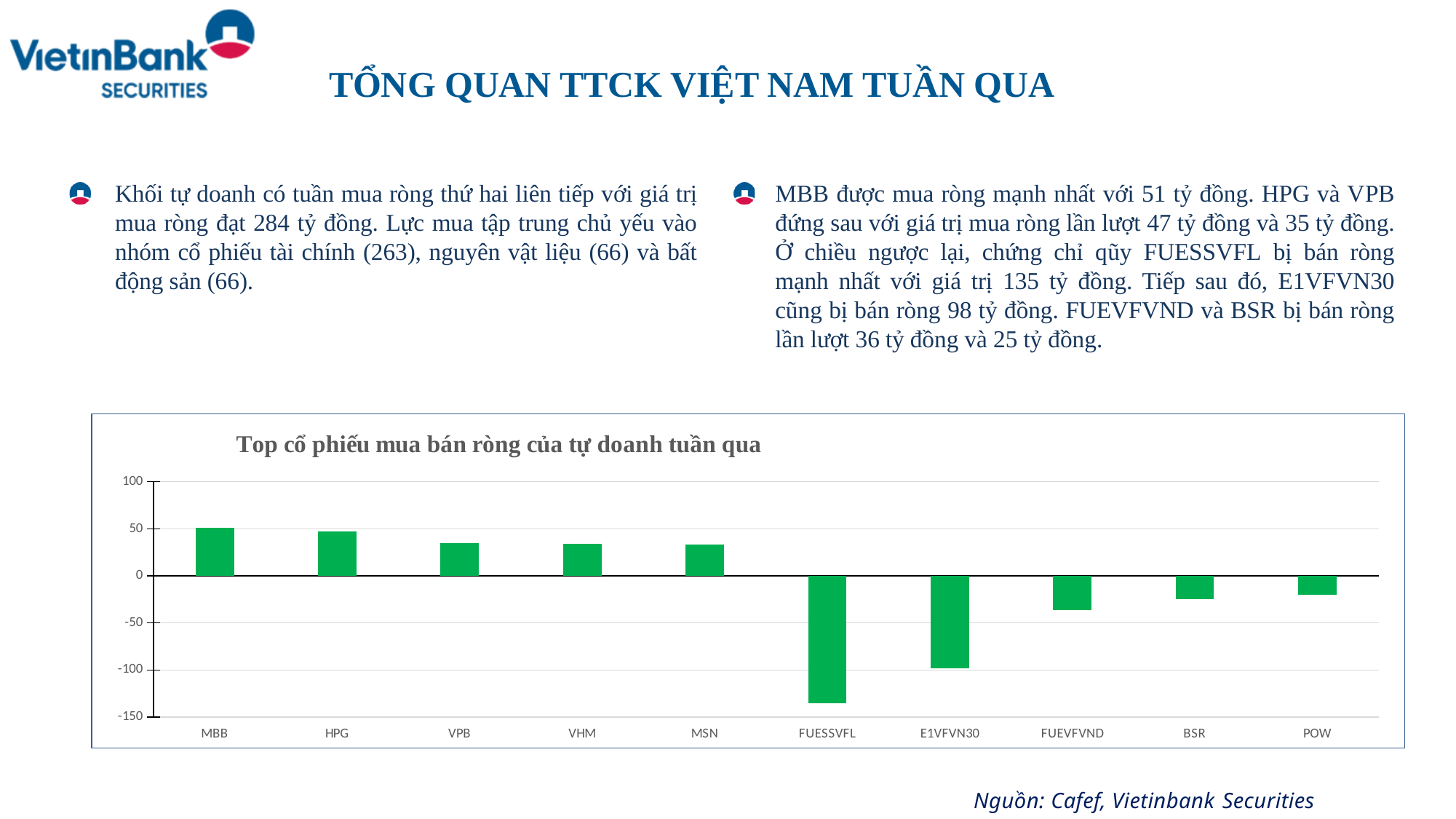
Is the value for VPB greater or less than 50? less Is the value for E1VFVN30 greater or less than -50? less Which category has the lowest value in the chart? FUESSVFL How many categories are shown on the x axis of the chart? 10 Is the value for FUEVFVND greater or less than -50? greater Which has the larger value, MBB or VPB? MBB What is the lowest tick value shown on the y axis of the chart? -150 What kind of chart is shown on the slide? bar chart Which has the larger value, E1VFVN30 or FUESSVFL? E1VFVN30 How many categories in the chart have a positive value? 5 What is the title of the chart? Top cổ phiếu mua bán ròng của tự doanh tuần qua